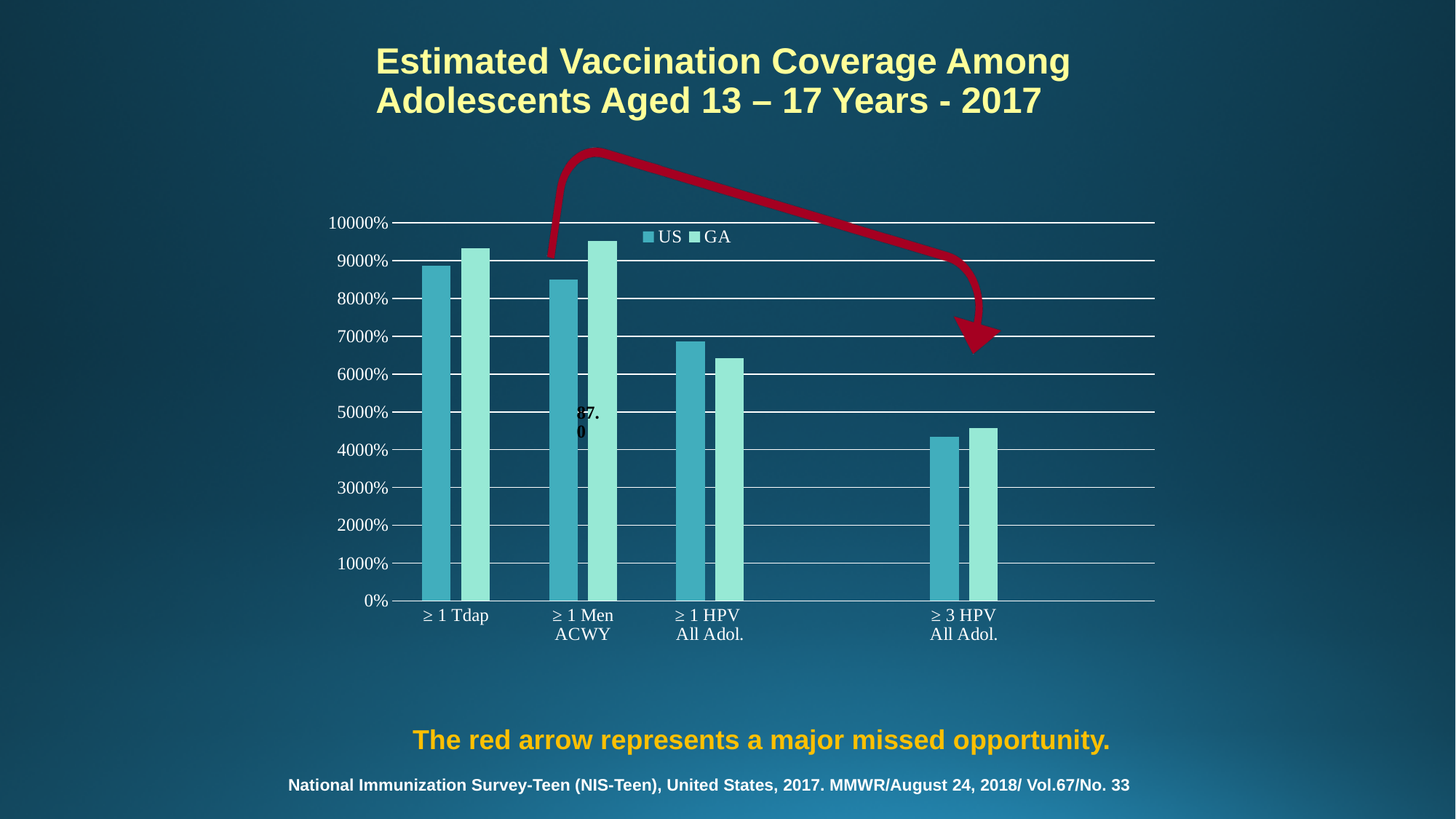
For ≥ 1 Tdap, which series has the larger value, US or GA? GA Which category has the lowest value for the US series? ≥ 3 HPV All Adol. How many vaccine categories are shown on the x axis? 4 Is the GA value for ≥ 1 Tdap greater or less than 9000%? greater Is the US value for ≥ 3 HPV All Adol. greater or less than 5000%? less Which category has the highest value for the GA series? ≥ 1 Men ACWY What kind of chart is shown on the slide? bar chart Which category has the lowest value for the GA series? ≥ 3 HPV All Adol. For ≥ 1 HPV All Adol., which series has the larger value, US or GA? US How many series does the legend list? 2 Do the US values rise or fall moving from left to right across the categories? fall Which two series are listed in the legend? US and GA